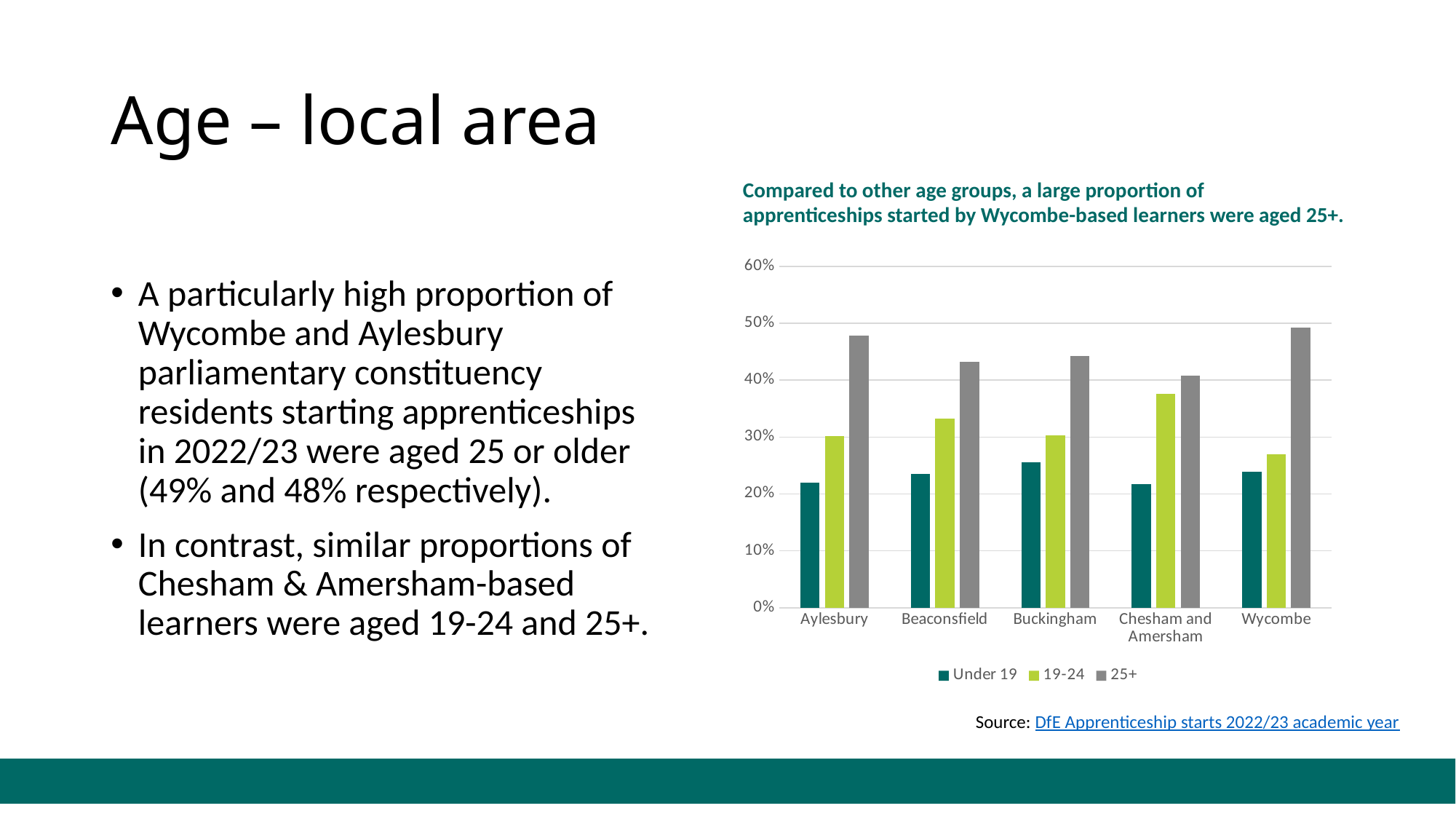
What proportion of apprenticeships started by Aylesbury residents were aged 25+? 48% What proportion of apprenticeships started by Wycombe residents were aged 25+? 49% Is the value for the 19-24 age group in Beaconsfield greater or less than 30%? greater How many constituencies are shown on the x axis of the chart? 5 How many series does the chart's legend list? 3 Is the value for the 25+ age group in Buckingham greater or less than 40%? greater In Beaconsfield, which is larger: the Under 19 bar or the 19-24 bar? 19-24 Which constituency has the highest value for the 19-24 age group? Chesham and Amersham What kind of chart is shown on the slide? bar chart Which constituency has the highest value for the 25+ age group? Wycombe What are the three age groups listed in the chart's legend? Under 19, 19-24, 25+ Is the value for the 19-24 age group in Wycombe greater or less than 30%? less